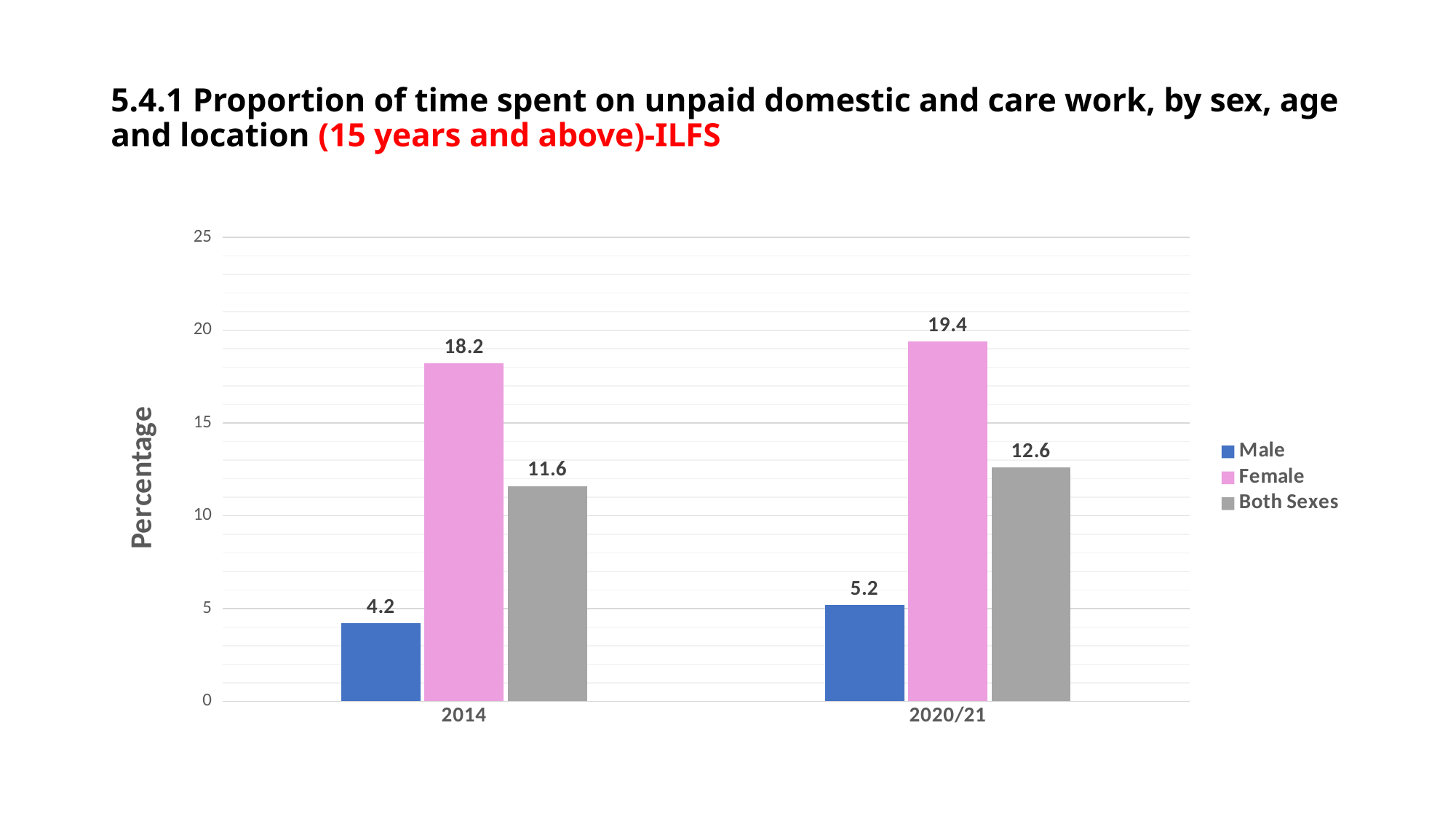
What kind of chart is shown on the slide? Bar chart Is the value for Female in 2014 greater or less than 15? greater What is the value for Female in 2014? 18.2 How many series does the legend list? 3 Which series has the highest value in 2020/21? Female What is the value for Male in 2020/21? 5.2 What is the label of the vertical axis? Percentage What is the value for Both Sexes in 2020/21? 12.6 Which is larger, the Male value in 2014 or the Male value in 2020/21? 2020/21 What is the value for Both Sexes in 2014? 11.6 What is the difference between the Female values in 2020/21 and 2014? 1.2 Which series has the lowest value in 2014? Male